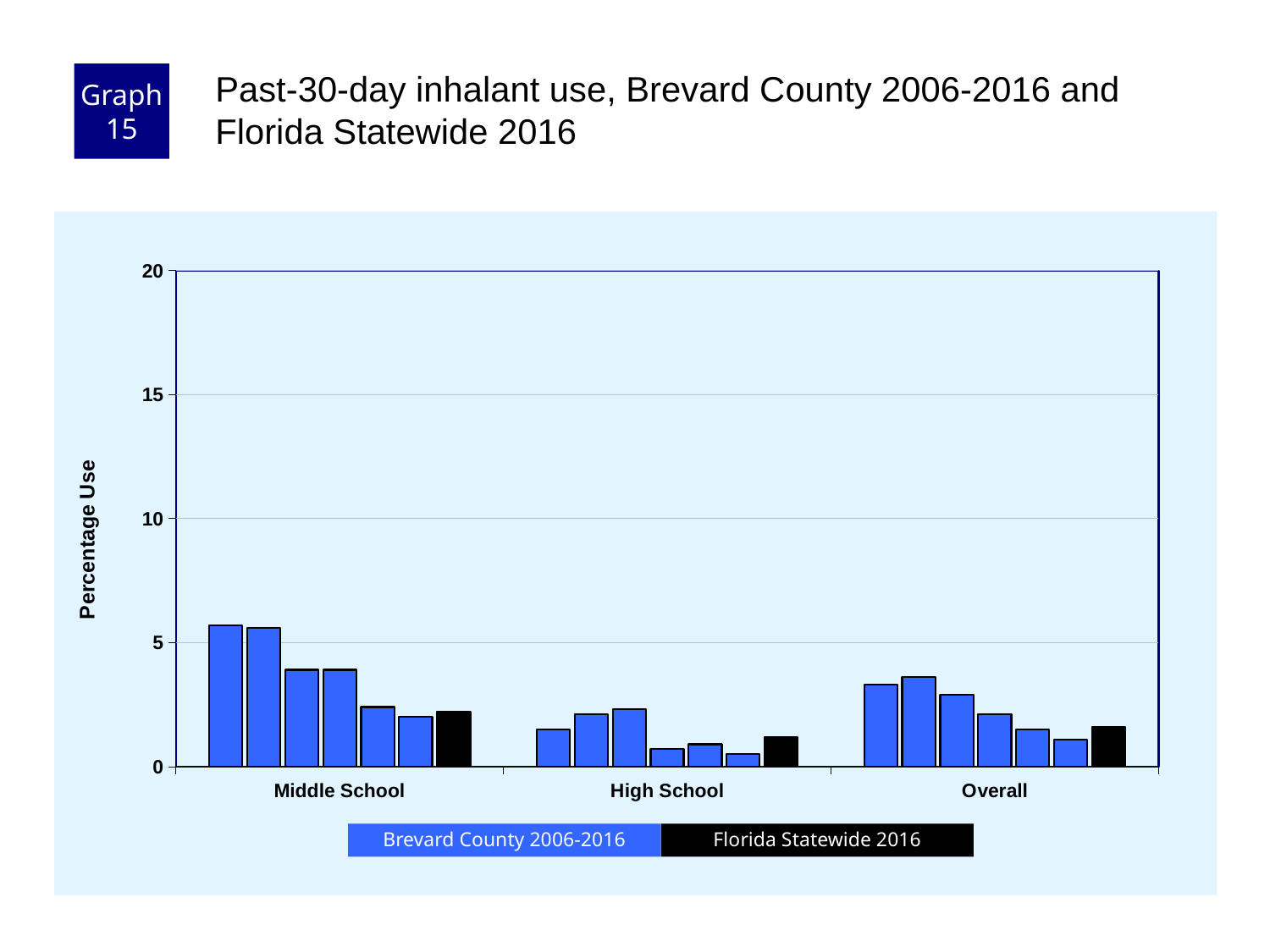
What kind of chart is shown on the slide? bar chart Which is larger, the Florida Statewide 2016 value for Middle School or for High School? Middle School Which category group contains the tallest bar in the chart? Middle School Do the Brevard County bars for Middle School generally rise or fall from 2006 to 2016? fall Is the Florida Statewide 2016 value for High School greater or less than 5? less Which colour represents Florida Statewide 2016 in the legend? black Is the tallest Middle School bar greater or less than 5? greater How many series does the legend list? 2 Are any bars in the chart greater than 10? No How many school-level categories are shown on the x axis? 3 What is the label on the y axis? Percentage Use